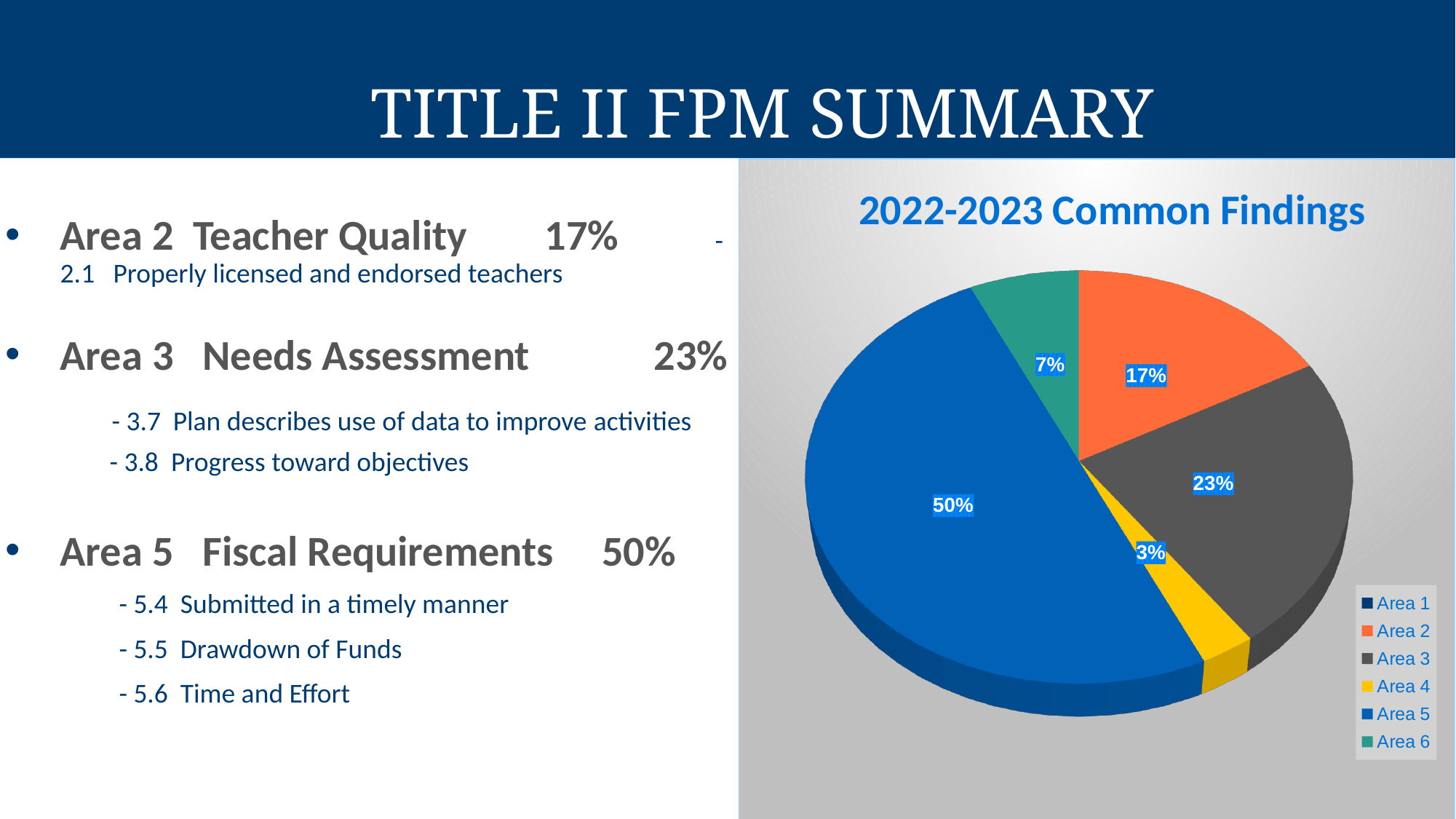
Which is larger, the slice for Area 2 or the slice for Area 6? Area 2 Which of the labeled slices is the smallest? Area 4 What percentage of the pie does Area 6 represent? 7% How many areas does the chart legend list? 6 What percentage of the pie does Area 2 represent? 17% What is the title of the chart? 2022-2023 Common Findings What is the difference in percentage points between Area 5 and Area 3? 27 What percentage of the pie does Area 3 represent? 23% What type of chart is shown on the slide? Pie chart What percentage of the pie does Area 4 represent? 3% What percentage of the pie does Area 5 represent? 50% Which area has the largest slice of the pie? Area 5